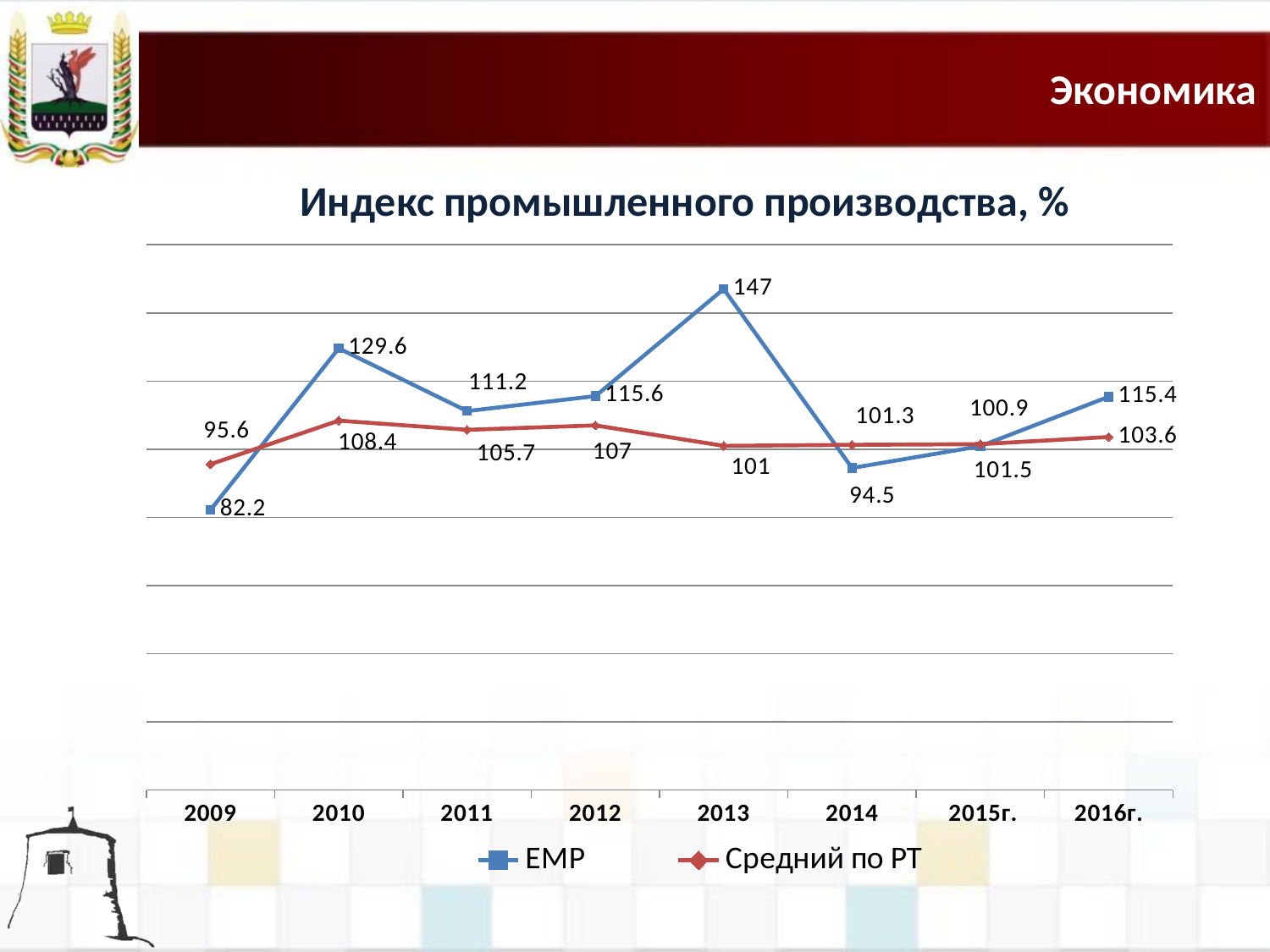
What kind of chart is shown on the slide? line chart What is the title of the chart? Индекс промышленного производства, % In which year is the ЕМР value lowest? 2009 What is the difference between ЕМР and Средний по РТ in 2013? 46 In which year is the ЕМР value highest? 2013 How many series does the legend list? 2 What is the value for ЕМР in 2013? 147 Does the ЕМР value rise or fall from 2013 to 2014? fall What is the value for Средний по РТ in 2010? 108.4 How many years are shown on the x axis? 8 Which series has the larger value in 2014, ЕМР or Средний по РТ? Средний по РТ What is the value for ЕМР in 2009? 82.2